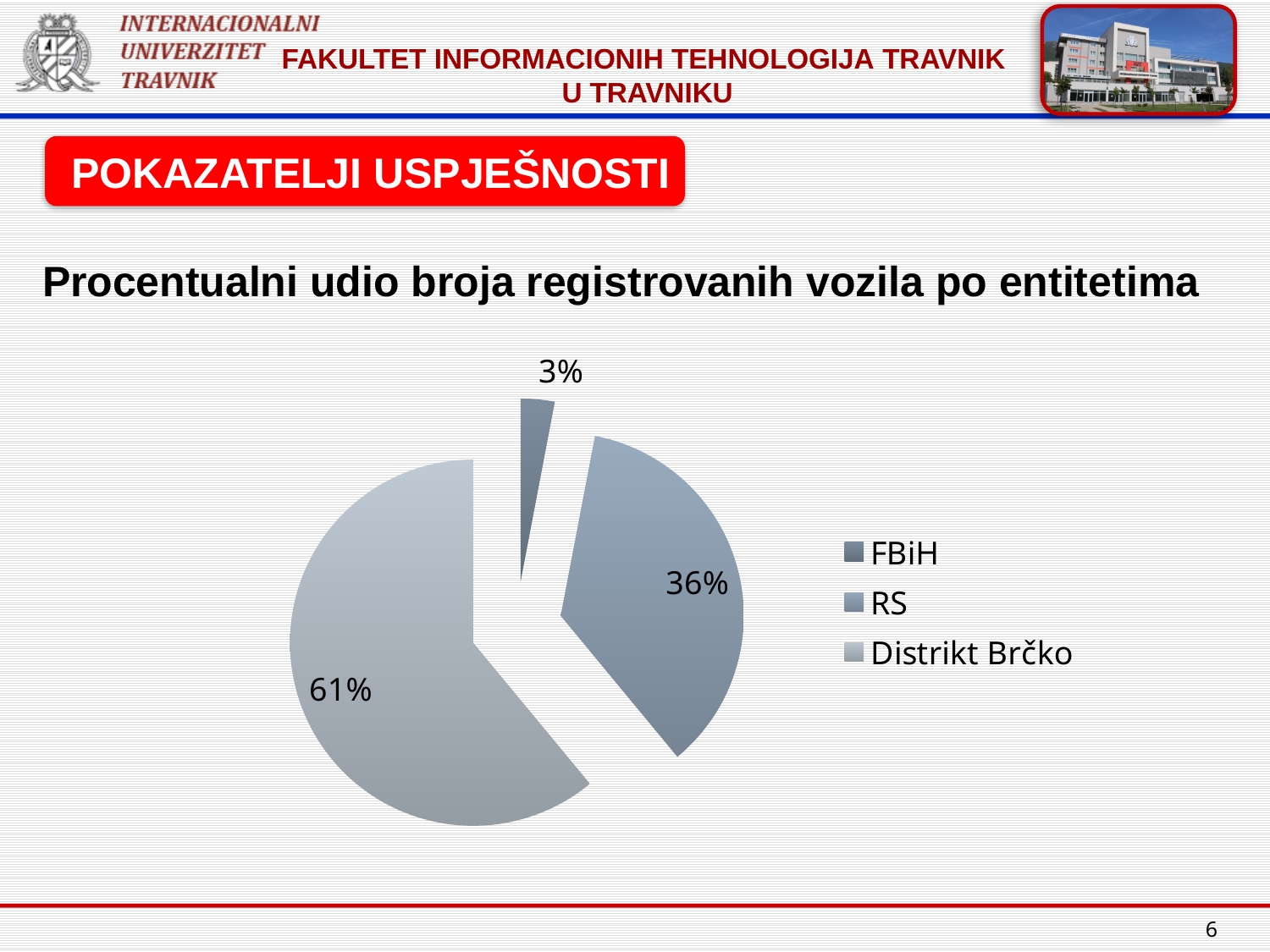
What percentage is shown for the Distrikt Brčko slice of the pie chart? 61% What is the difference in percentage points between the 61% slice and the 36% slice? 25 Which legend entry corresponds to the largest slice of the pie chart? Distrikt Brčko Which legend entry corresponds to the smallest slice of the pie chart? FBiH What percentage is shown for the RS slice of the pie chart? 36% What kind of chart is shown on the slide? pie chart Which legend entry is listed first in the pie chart's legend? FBiH What percentage is shown for the FBiH slice of the pie chart? 3% How many slices does the pie chart have? 3 What is the title text above the pie chart? Procentualni udio broja registrovanih vozila po entitetima Which slice is larger, RS or FBiH? RS How many entries does the legend of the pie chart list? 3